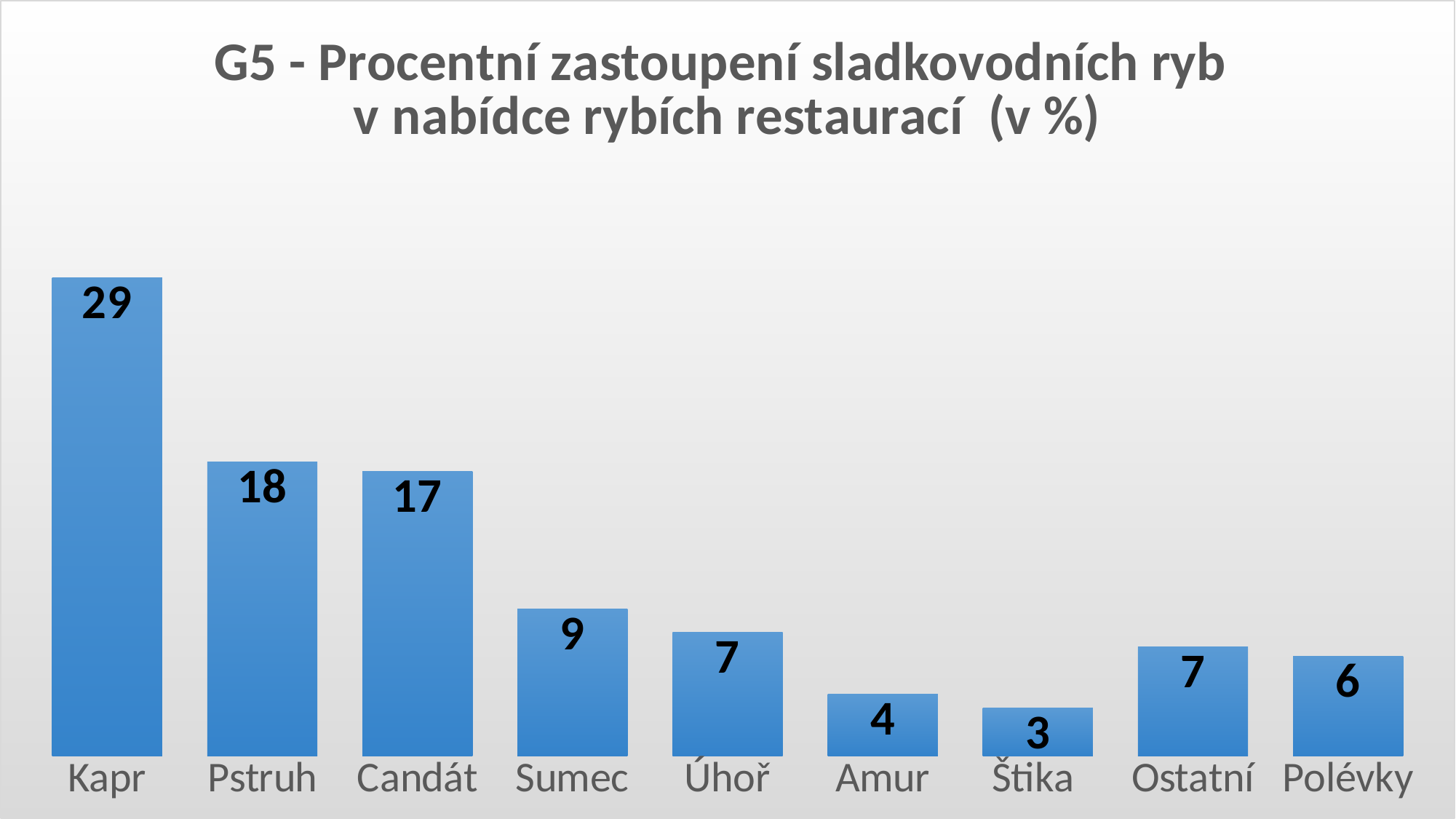
Which category has the highest value? Kapr What kind of chart is shown on the slide? Bar chart Which is larger, the value for Pstruh or the value for Candát? Pstruh What is the title of the chart? G5 - Procentní zastoupení sladkovodních ryb v nabídce rybích restaurací (v %) How many categories are shown in the chart? 9 Which is larger, the value for Amur or the value for Štika? Amur What is the value for Sumec? 9 What is the difference between the values for Candát and Sumec? 8 What is the value for Polévky? 6 Which category has the lowest value? Štika What is the difference between the values for Kapr and Pstruh? 11 What is the value for Kapr? 29